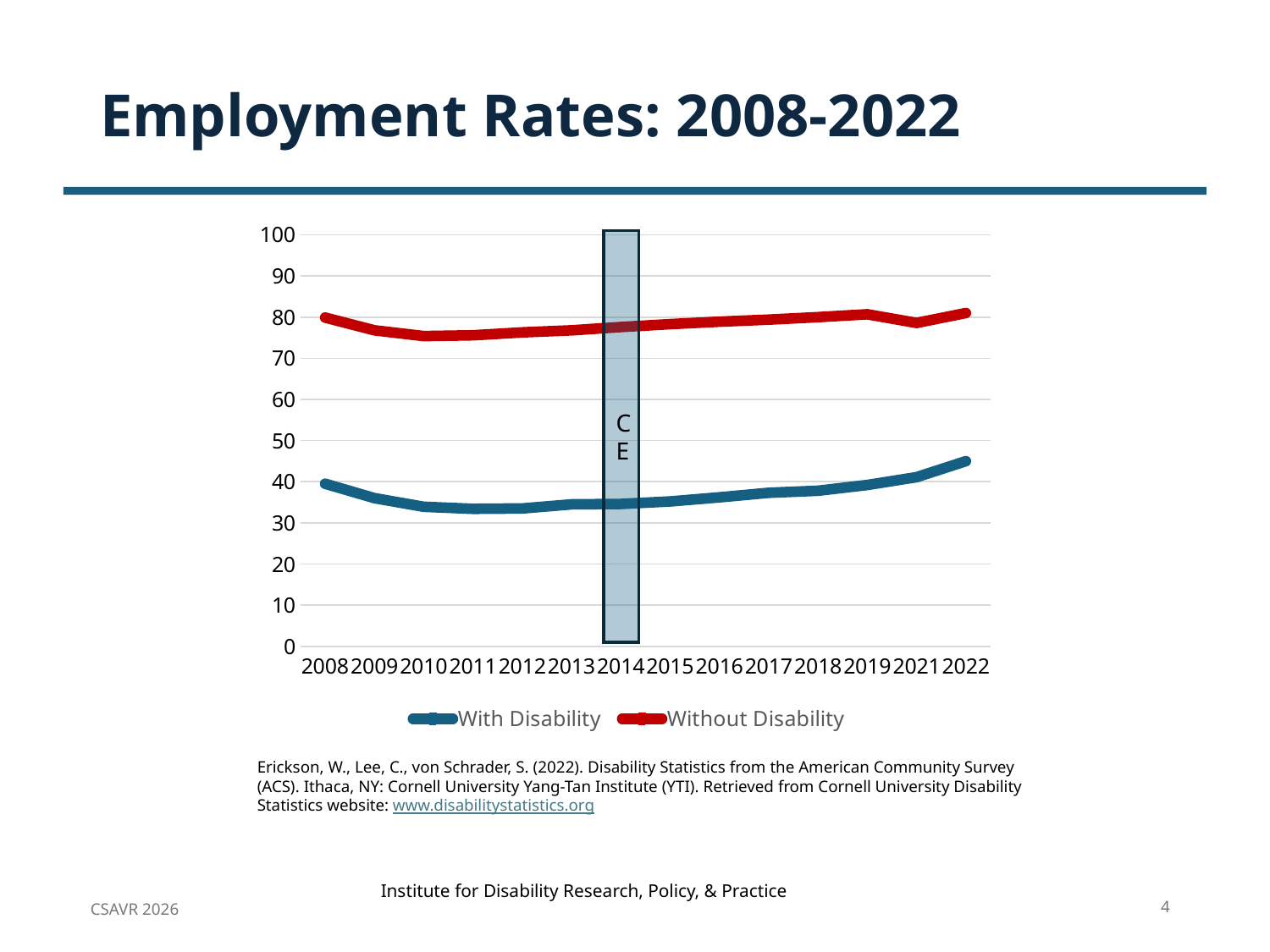
Does the With Disability line rise or fall from 2011 to 2022? Rise Which is larger for the With Disability series, the value in 2008 or the value in 2022? 2022 Is the Without Disability value for 2008 greater or less than 70? greater Is the Without Disability value for 2010 greater or less than 80? less What is the title of the chart on the slide? Employment Rates: 2008-2022 In which year is the With Disability employment rate highest? 2022 Is the With Disability value for 2010 greater or less than 40? less How many years are shown along the x axis? 14 What kind of chart is shown on the slide? Line chart How many series does the legend list? 2 Which series has the higher value in 2015, With Disability or Without Disability? Without Disability